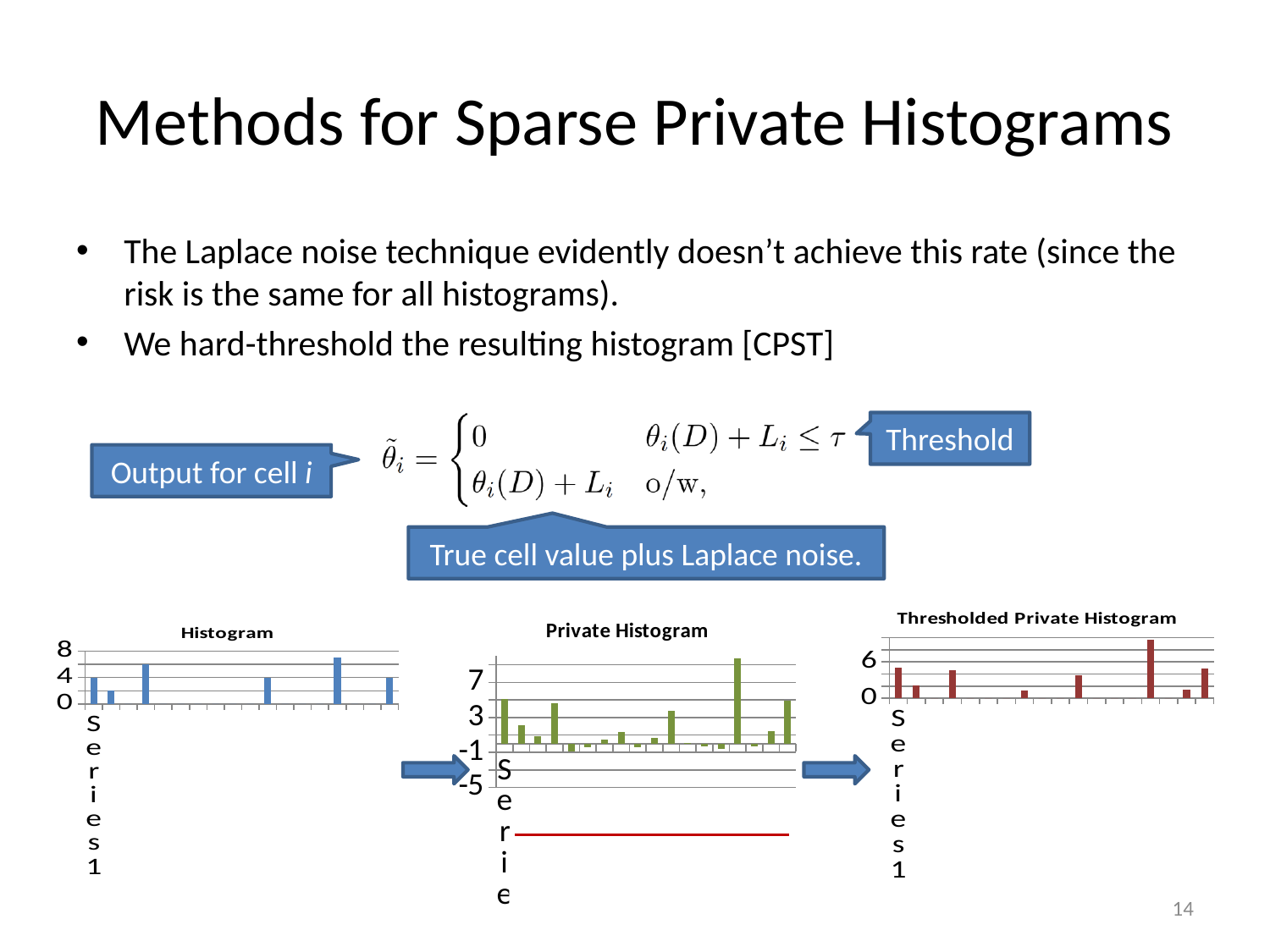
In the "Histogram" chart, is the tallest bar greater or less than 4? greater What kind of chart is the chart titled "Private Histogram"? bar chart What colour are the bars in the "Thresholded Private Histogram" chart? red What kind of chart is the chart titled "Thresholded Private Histogram"? bar chart What kind of chart is the chart titled "Histogram"? bar chart In the "Thresholded Private Histogram" chart, is the tallest bar greater or less than 6? greater In the "Private Histogram" chart, is the tallest bar greater or less than 3? greater What is the title of the leftmost chart on the slide? Histogram